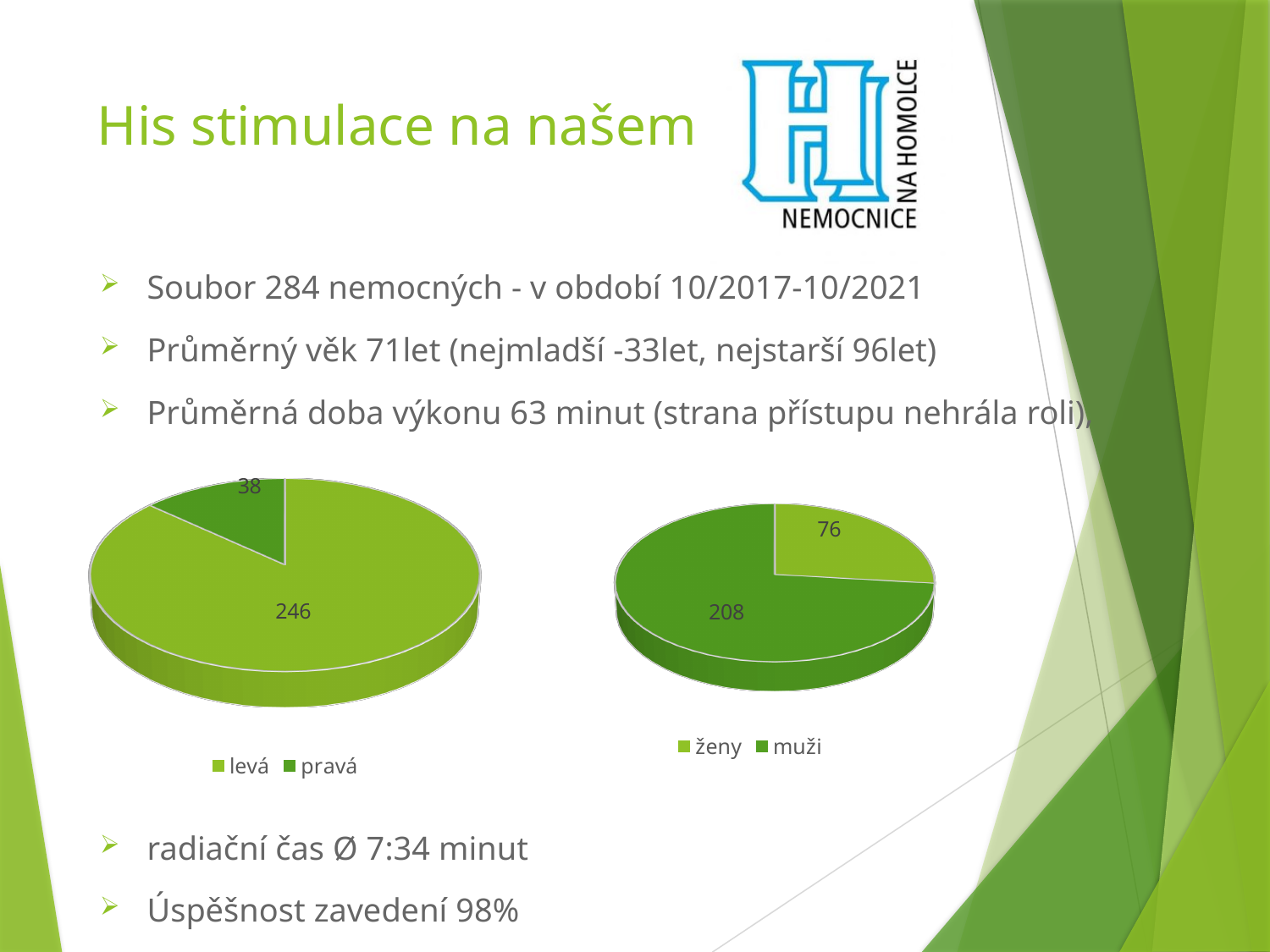
In the left pie chart, what is the difference between the values for levá and pravá? 208 In the right pie chart, what is the value for ženy? 76 In the right pie chart, what is the difference between the values for muži and ženy? 132 In the right pie chart, what is the value for muži? 208 In the right pie chart, which is larger, ženy or muži? muži What kind of chart is the chart on the right side of the slide? pie chart In the right pie chart, which category has the smallest slice? ženy In the left pie chart, what is the value for levá? 246 How many categories does the legend of the left pie chart list? 2 In the left pie chart, what is the value for pravá? 38 What is the total of the two slices in the left pie chart? 284 In the left pie chart, which category has the largest slice? levá